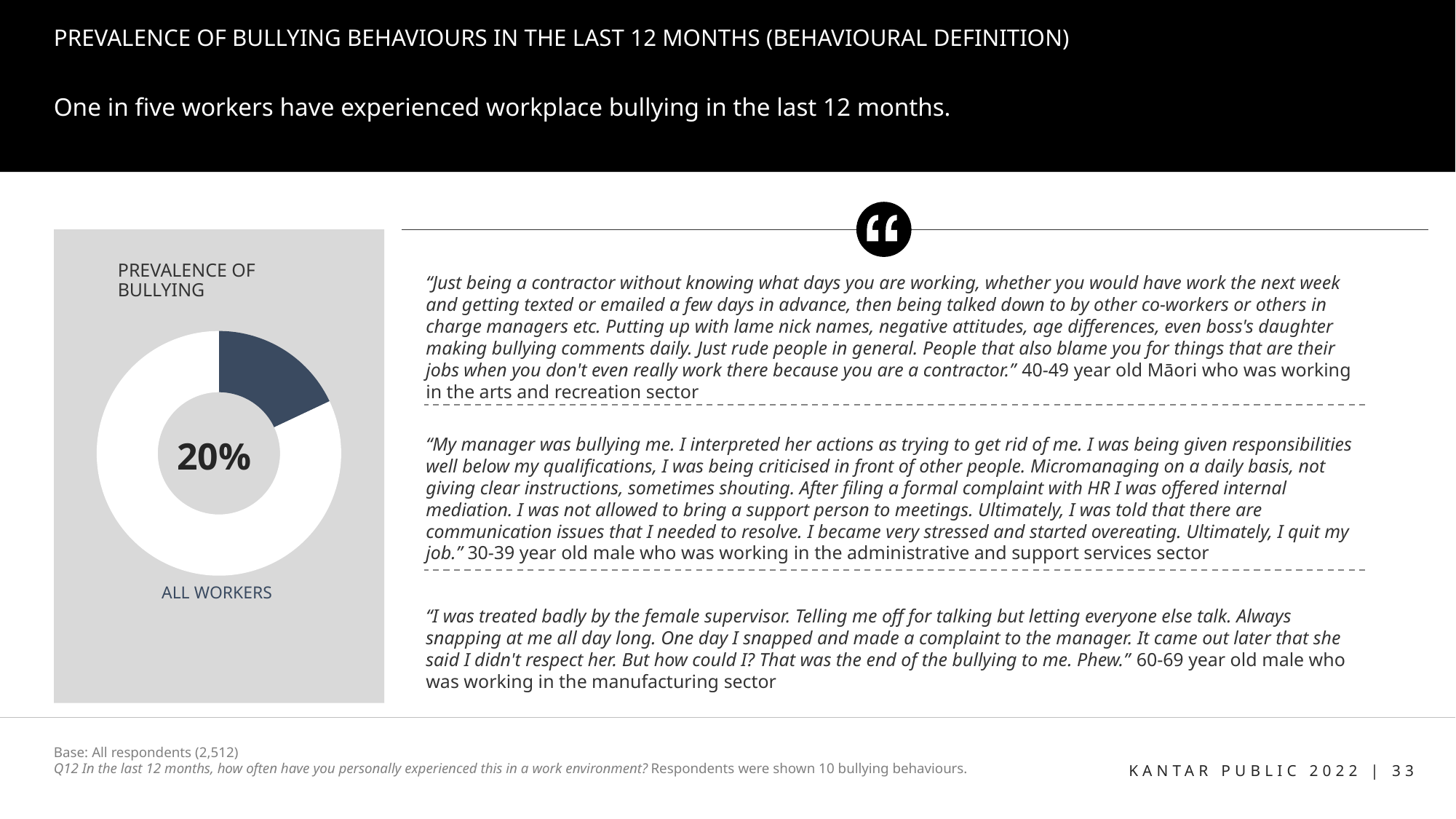
What share of the donut chart is filled by the dark segment representing bullying prevalence? 20% Is the prevalence of bullying shown in the chart greater or less than 50%? less How many groups are plotted in the prevalence of bullying chart? 1 What kind of chart is used to show the prevalence of bullying? Donut (pie) chart What is the title of the chart on the left of the slide? PREVALENCE OF BULLYING What share of the donut chart is not filled by the dark bullying segment? 80% What percentage is shown in the centre of the donut chart? 20% Which group does the donut chart represent, according to the label beneath it? ALL WORKERS